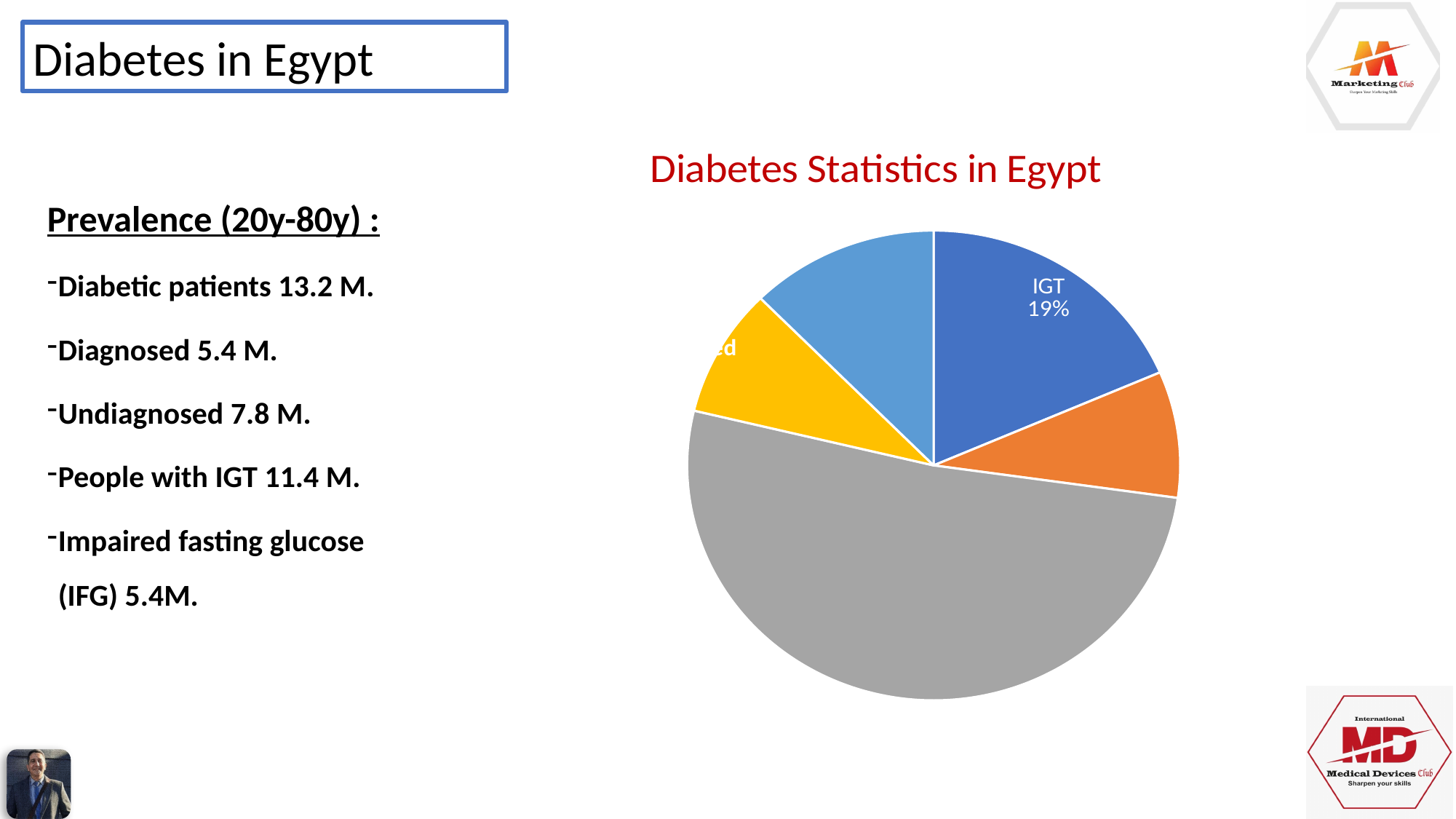
What is the title of the chart? Diabetes Statistics in Egypt What kind of chart is shown on the slide? pie chart What share of the pie does the IGT slice represent? 19% Is the IGT slice the largest slice in the pie chart? No What colour is the largest slice of the pie chart? gray How many slices does the pie chart have? 5 Is the share for IGT greater or less than 25%? less Is the IGT slice larger or smaller than the gray slice? smaller